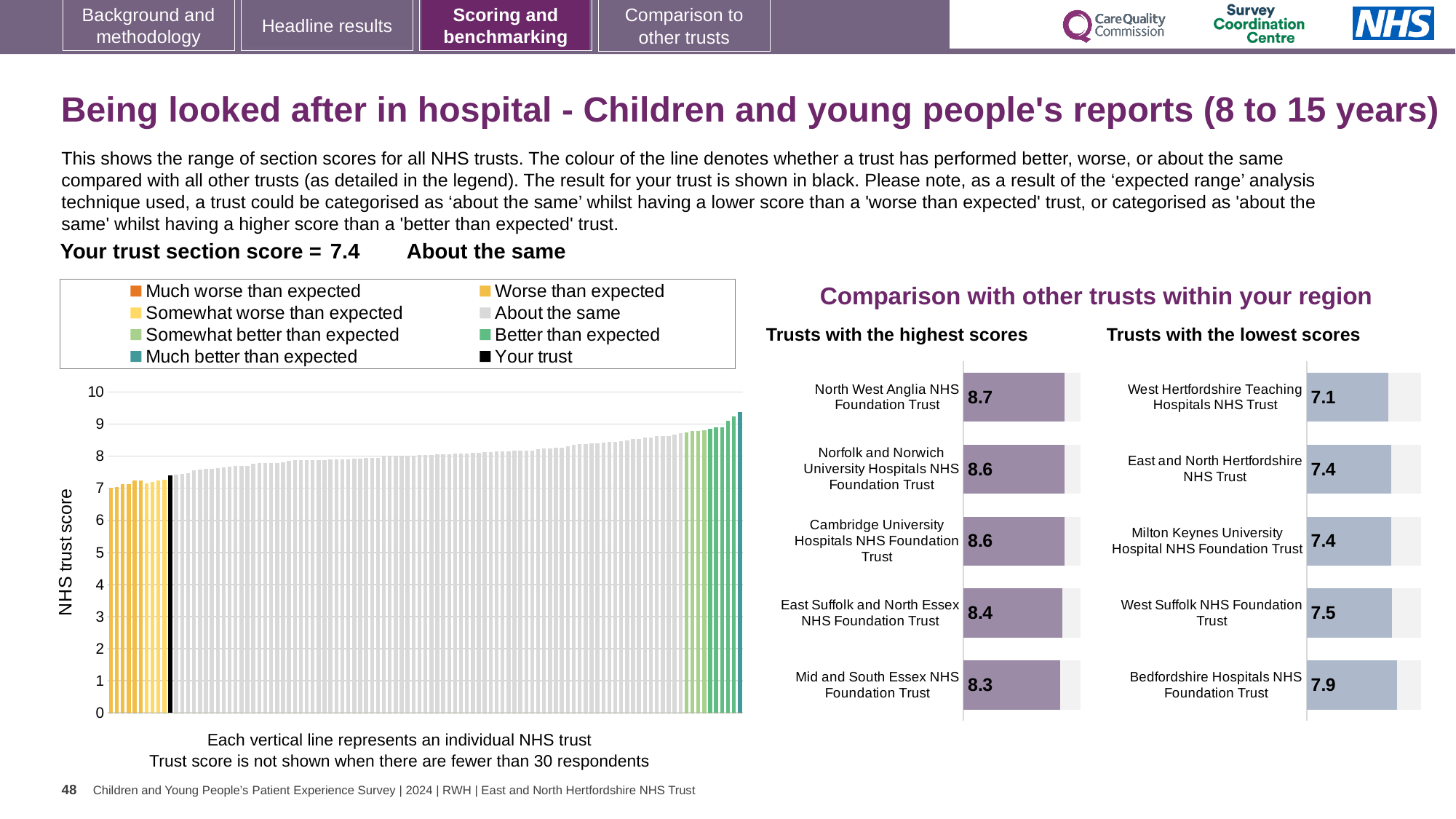
In the 'Trusts with the highest scores' chart, which trust has the highest score? North West Anglia NHS Foundation Trust In the 'Trusts with the lowest scores' chart, how much higher is Bedfordshire Hospitals NHS Foundation Trust's score than West Hertfordshire Teaching Hospitals NHS Trust's score? 0.8 In the 'Trusts with the highest scores' chart, what is the score for North West Anglia NHS Foundation Trust? 8.7 What kind of chart is the large chart on the left showing all NHS trusts? Bar chart In the 'Trusts with the lowest scores' chart, what is the score for Bedfordshire Hospitals NHS Foundation Trust? 7.9 In the large chart on the left, what is the section score for your trust (the black bar)? 7.4 In the large chart on the left, do the trust scores rise or fall from left to right? Rise Which has the larger score: East Suffolk and North Essex NHS Foundation Trust in the highest scores chart, or West Suffolk NHS Foundation Trust in the lowest scores chart? East Suffolk and North Essex NHS Foundation Trust In the 'Trusts with the lowest scores' chart, which trust has the lowest score? West Hertfordshire Teaching Hospitals NHS Trust How many entries does the legend above the large chart on the left list? 8 In the 'Trusts with the highest scores' chart, what is the difference between the scores of North West Anglia NHS Foundation Trust and Mid and South Essex NHS Foundation Trust? 0.4 How many trusts are shown in the 'Trusts with the highest scores' chart? 5